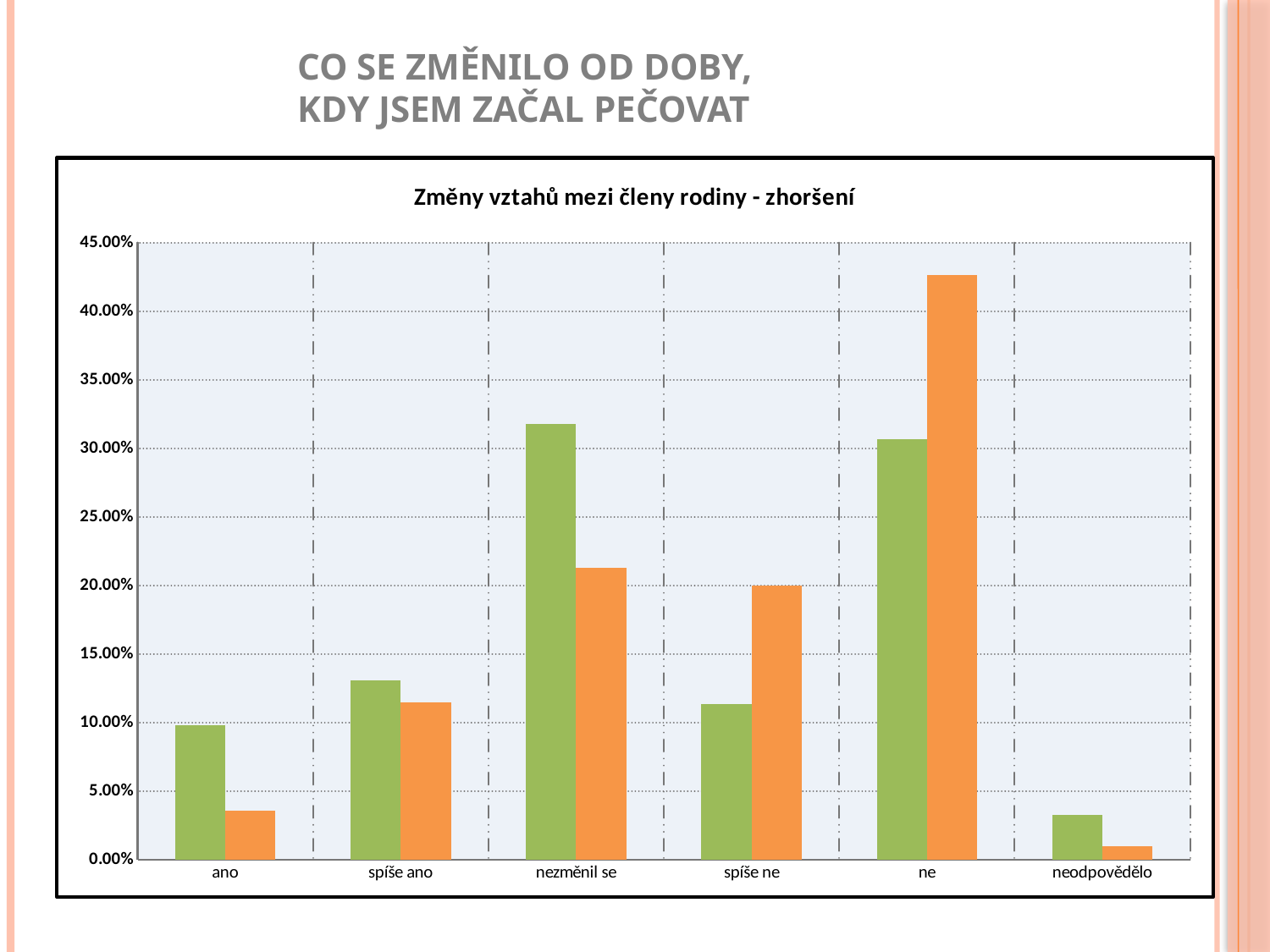
For the category 'spíše ne', which bar is taller, the green one or the orange one? orange Which category has the lowest green bar? neodpovědělo Is the orange bar for 'ne' greater or less than 40.00%? greater For the category 'nezměnil se', which bar is taller, the green one or the orange one? green What is the title of the chart? Změny vztahů mezi členy rodiny - zhoršení How many bars are plotted for each category in the chart? 2 Which category has the highest orange bar? ne Is the green bar for 'nezměnil se' greater or less than 30.00%? greater Is the orange bar for 'ano' greater or less than 5.00%? less How many categories are shown on the x axis of the chart? 6 Which category has the lowest orange bar? neodpovědělo What type of chart is shown on the slide? bar chart